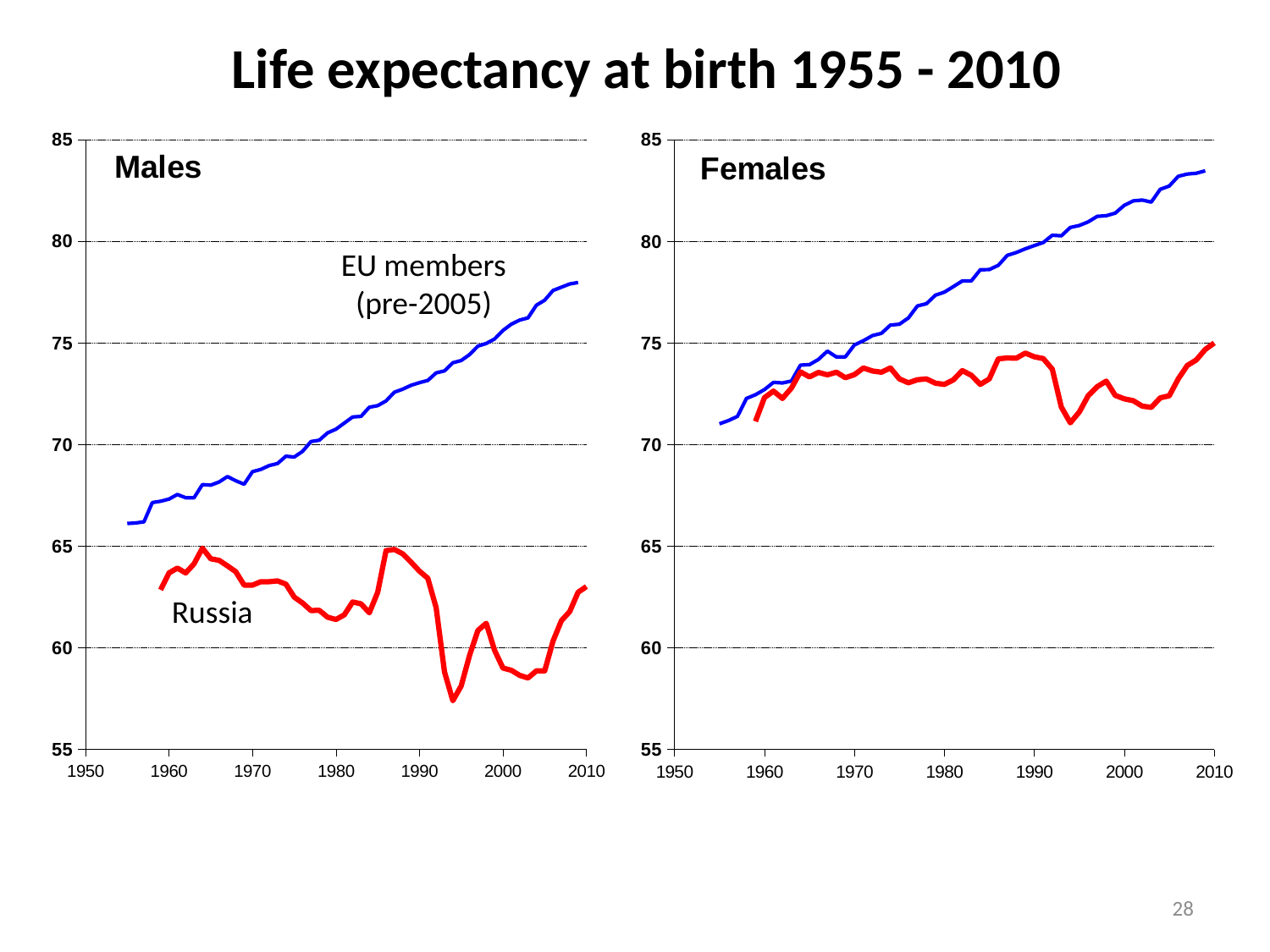
What is the title of the slide? Life expectancy at birth 1955 - 2010 On the Females chart, is the value of the red line in 1994 greater or less than 75? less What kind of chart is the Males chart? line chart On the Males chart, is the value for EU members (pre-2005) in 1960 greater or less than 70? less On the Males chart, which series is labelled with the red line? Russia How many lines are plotted on the Females chart? 2 On the Males chart, is the value for EU members (pre-2005) in 2000 greater or less than 75? greater On the Males chart, does the EU members (pre-2005) line rise or fall from 1955 to 2010? rise On the Males chart, does the Russia line rise or fall between 1987 and 1994? fall On the Males chart, which series is higher in 2000, EU members (pre-2005) or Russia? EU members (pre-2005)